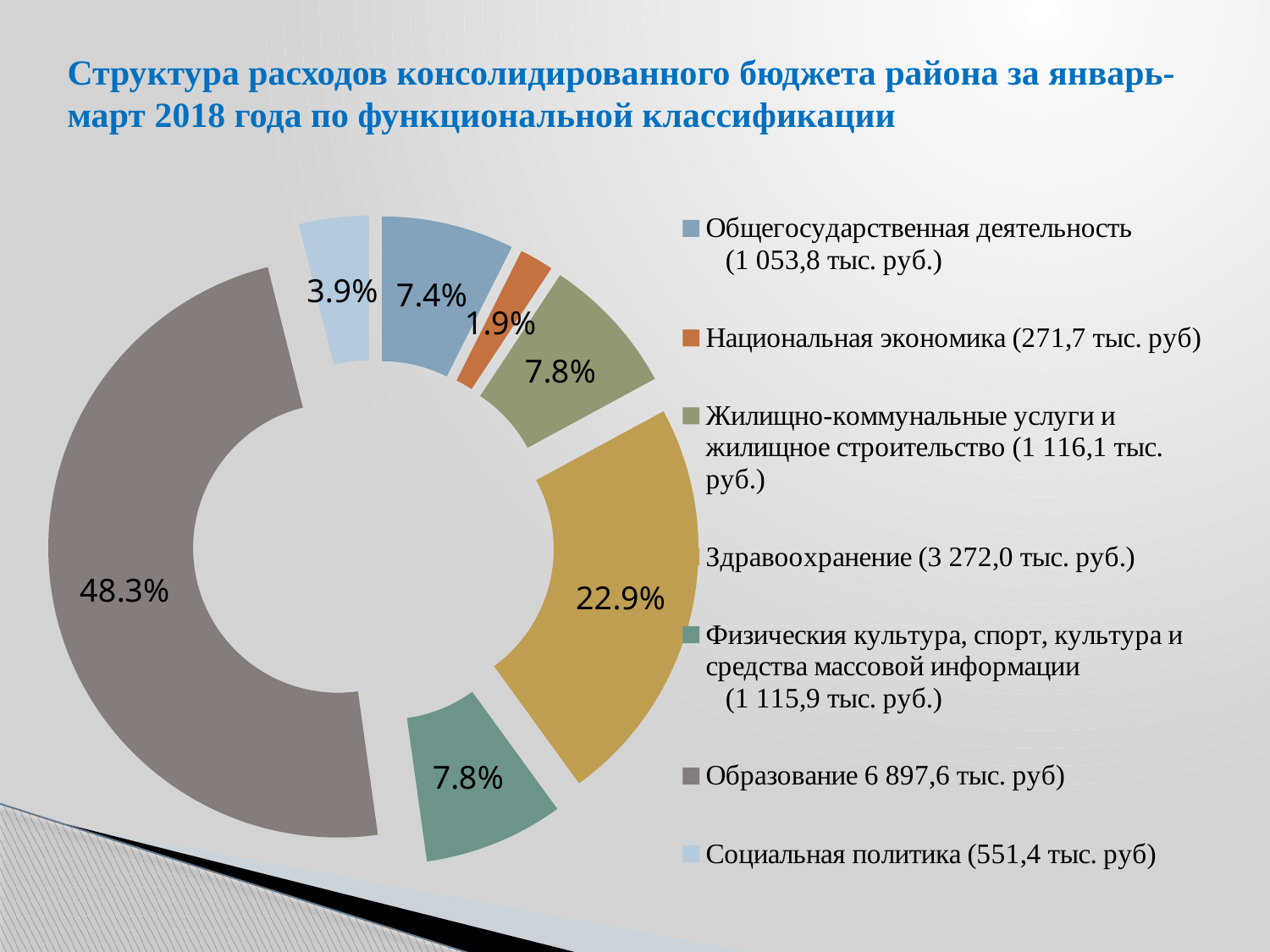
What colour represents Образование in the chart? Gray What type of chart is shown on the slide? Doughnut (pie) chart What is the difference in percentage points between the shares of Образование and Здравоохранение? 25.4 What share of expenditures does Образование account for? 48.3% Which has a larger share: Общегосударственная деятельность or Социальная политика? Общегосударственная деятельность What share of expenditures does Здравоохранение account for? 22.9% Which category has the largest share of the budget expenditures? Образование Which category has the smallest share of the budget expenditures? Национальная экономика According to the legend, what is the amount for Здравоохранение in thousand rubles? 3 272,0 тыс. руб. How many categories are shown in the chart? 7 What percentage is shown for Социальная политика? 3.9% What percentage is shown for Национальная экономика? 1.9%